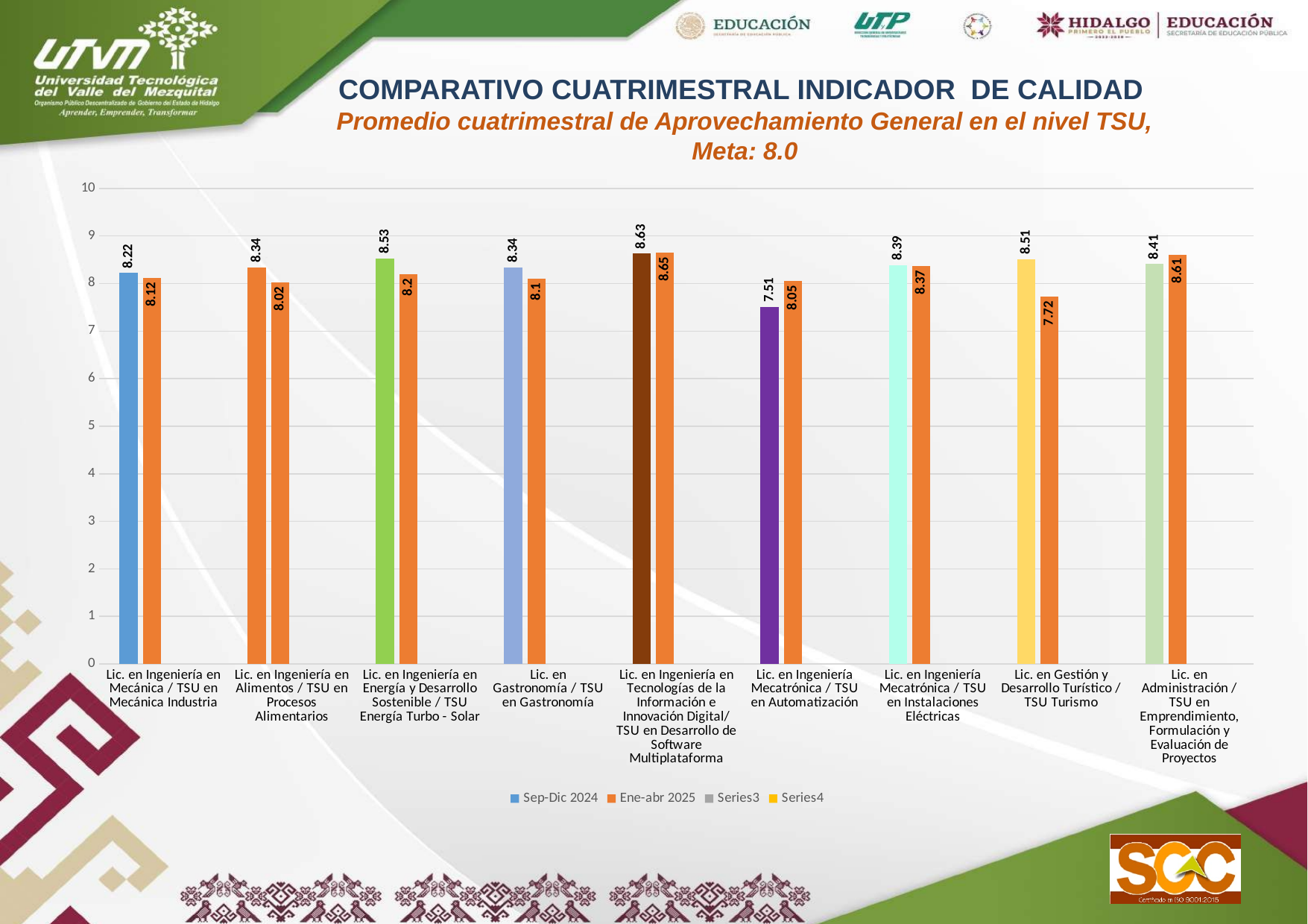
What is the Sep-Dic 2024 value for Lic. en Gastronomía / TSU en Gastronomía? 8.34 Is the Sep-Dic 2024 value for Lic. en Ingeniería Mecatrónica / TSU en Automatización greater or less than 8? less How many programs (categories) are shown on the x axis? 9 What is the Ene-abr 2025 value for Lic. en Ingeniería Mecatrónica / TSU en Automatización? 8.05 What kind of chart is shown on the slide? Bar chart Which program has the lowest Sep-Dic 2024 value? Lic. en Ingeniería Mecatrónica / TSU en Automatización What is the Ene-abr 2025 value for Lic. en Gestión y Desarrollo Turístico / TSU Turismo? 7.72 Which program has the lowest Ene-abr 2025 value? Lic. en Gestión y Desarrollo Turístico / TSU Turismo What is the difference between the Sep-Dic 2024 and Ene-abr 2025 values for Lic. en Gestión y Desarrollo Turístico / TSU Turismo? 0.79 For Lic. en Ingeniería Mecatrónica / TSU en Automatización, which is larger: the Sep-Dic 2024 value or the Ene-abr 2025 value? Ene-abr 2025 Which program has the highest Sep-Dic 2024 value? Lic. en Ingeniería en Tecnologías de la Información e Innovación Digital/ TSU en Desarrollo de Software Multiplataforma How many series does the legend list? 4